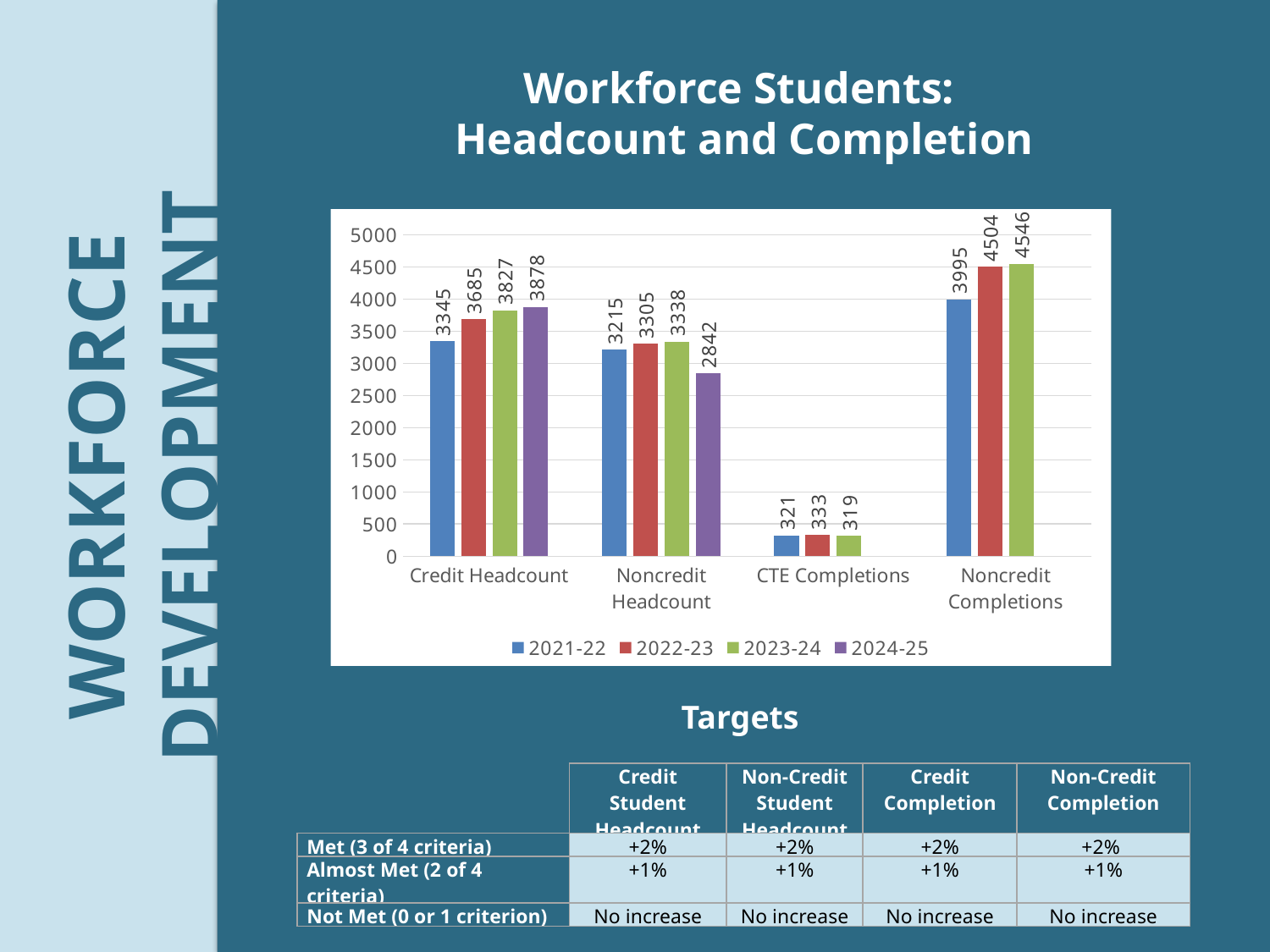
What is the value for CTE Completions in 2022-23? 333 How many series does the legend list? 4 Which is larger: Noncredit Completions in 2022-23 or Credit Headcount in 2022-23? Noncredit Completions in 2022-23 What is the difference between the Credit Headcount in 2024-25 and in 2021-22? 533 What is the value for Noncredit Completions in 2023-24? 4546 What kind of chart is shown on the slide? Bar chart Does the Credit Headcount rise or fall from 2021-22 to 2024-25? Rise Which year has the lowest Noncredit Headcount? 2024-25 What is the Credit Headcount for 2021-22? 3345 What is the Noncredit Headcount for 2024-25? 2842 Which year has the highest Credit Headcount? 2024-25 How many categories are shown on the x axis? 4